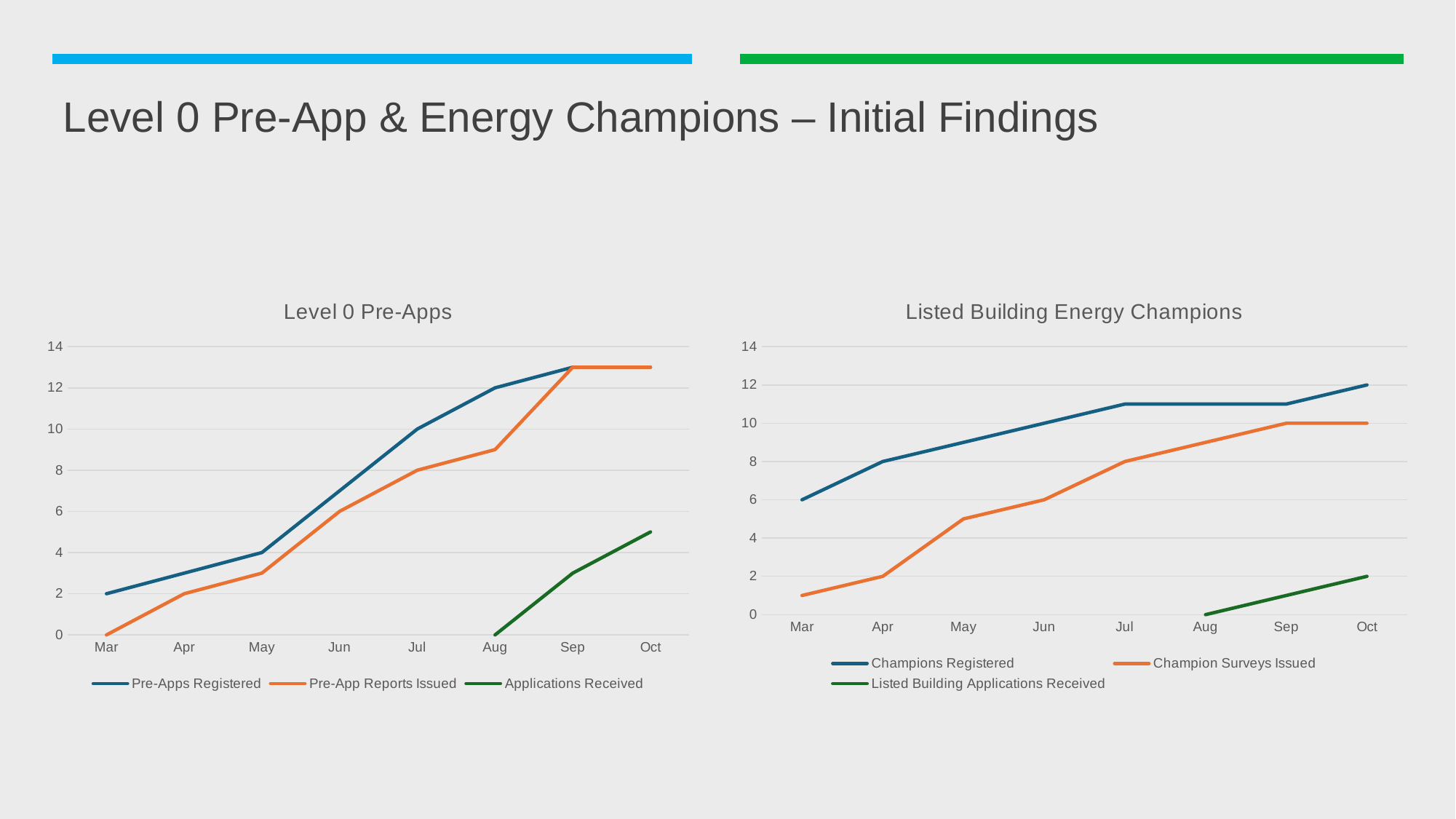
What kind of chart is the 'Level 0 Pre-Apps' chart? line chart What is the title of the chart on the right side of the slide? Listed Building Energy Champions In the 'Listed Building Energy Champions' chart, which series is higher in Oct: Champions Registered or Champion Surveys Issued? Champions Registered How many series does the legend of the 'Listed Building Energy Champions' chart list? 3 In the 'Listed Building Energy Champions' chart, what is the value of Champions Registered in Mar? 6 In the 'Listed Building Energy Champions' chart, does the Champions Registered line rise or fall from Mar to Oct? rise In the 'Level 0 Pre-Apps' chart, is the value for Pre-Apps Registered in Sep greater or less than 12? greater In the 'Level 0 Pre-Apps' chart, what is the value of Pre-Apps Registered in Mar? 2 In the 'Level 0 Pre-Apps' chart, what is the value of Pre-App Reports Issued in Jul? 8 How many series does the legend of the 'Level 0 Pre-Apps' chart list? 3 In the 'Listed Building Energy Champions' chart, what is the value of Champion Surveys Issued in Sep? 10 How many months are shown on the x axis of the 'Listed Building Energy Champions' chart? 8